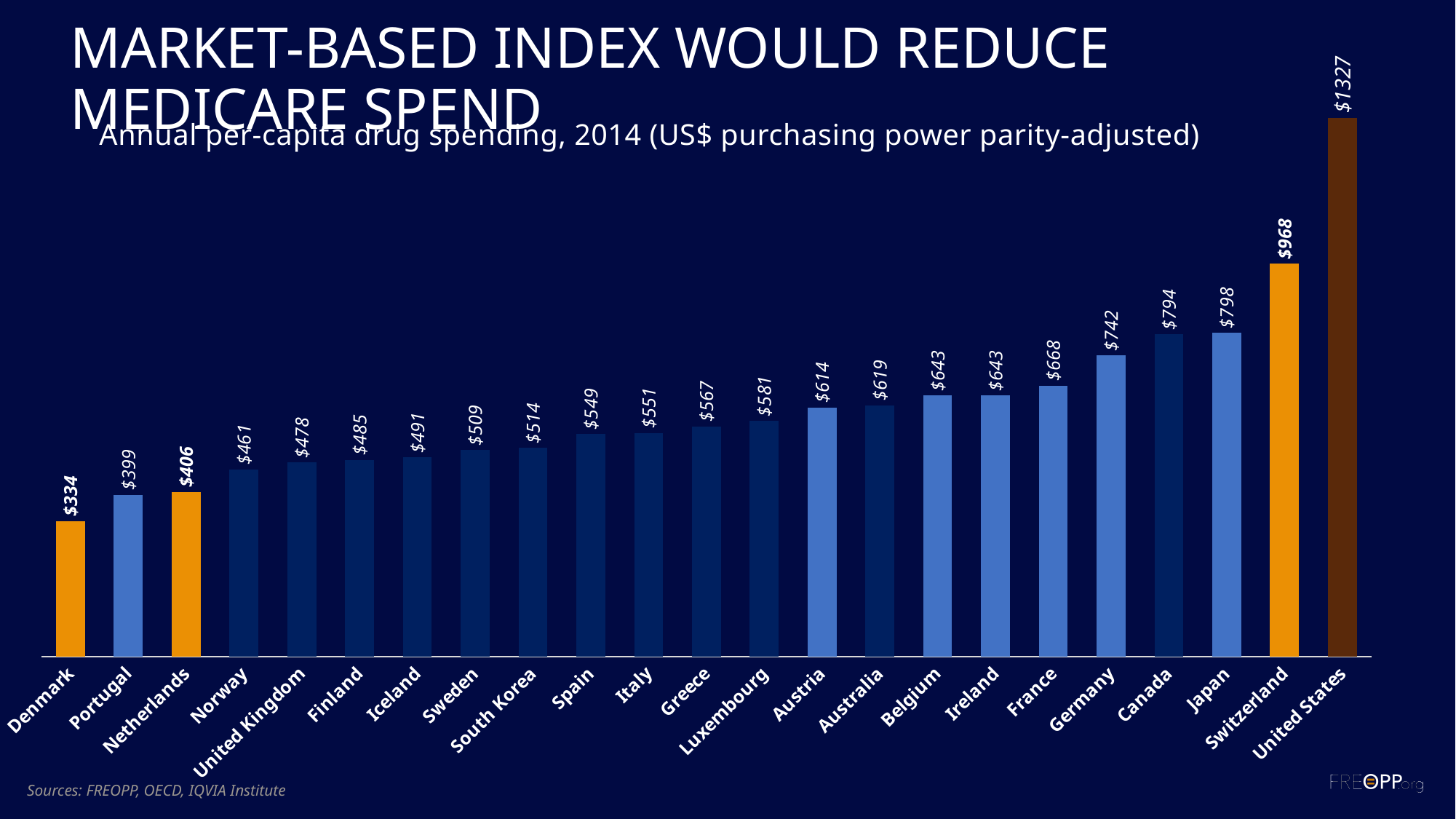
What is the difference between the values for the United States and Switzerland? $359 What is the difference between the values for Canada and Denmark? $460 Which country has the lowest per-capita drug spending on the chart? Denmark Which has a higher value, Japan or France? Japan What is the value shown for Luxembourg? $581 What kind of chart is shown on the slide? Bar chart What is the annual per-capita drug spending shown for Germany? $742 How many countries are shown on the chart? 23 What colour is the bar for the United States? Brown Do the values rise or fall moving from left to right along the x axis? Rise Which country has the highest per-capita drug spending on the chart? United States What is the value shown for the Netherlands? $406